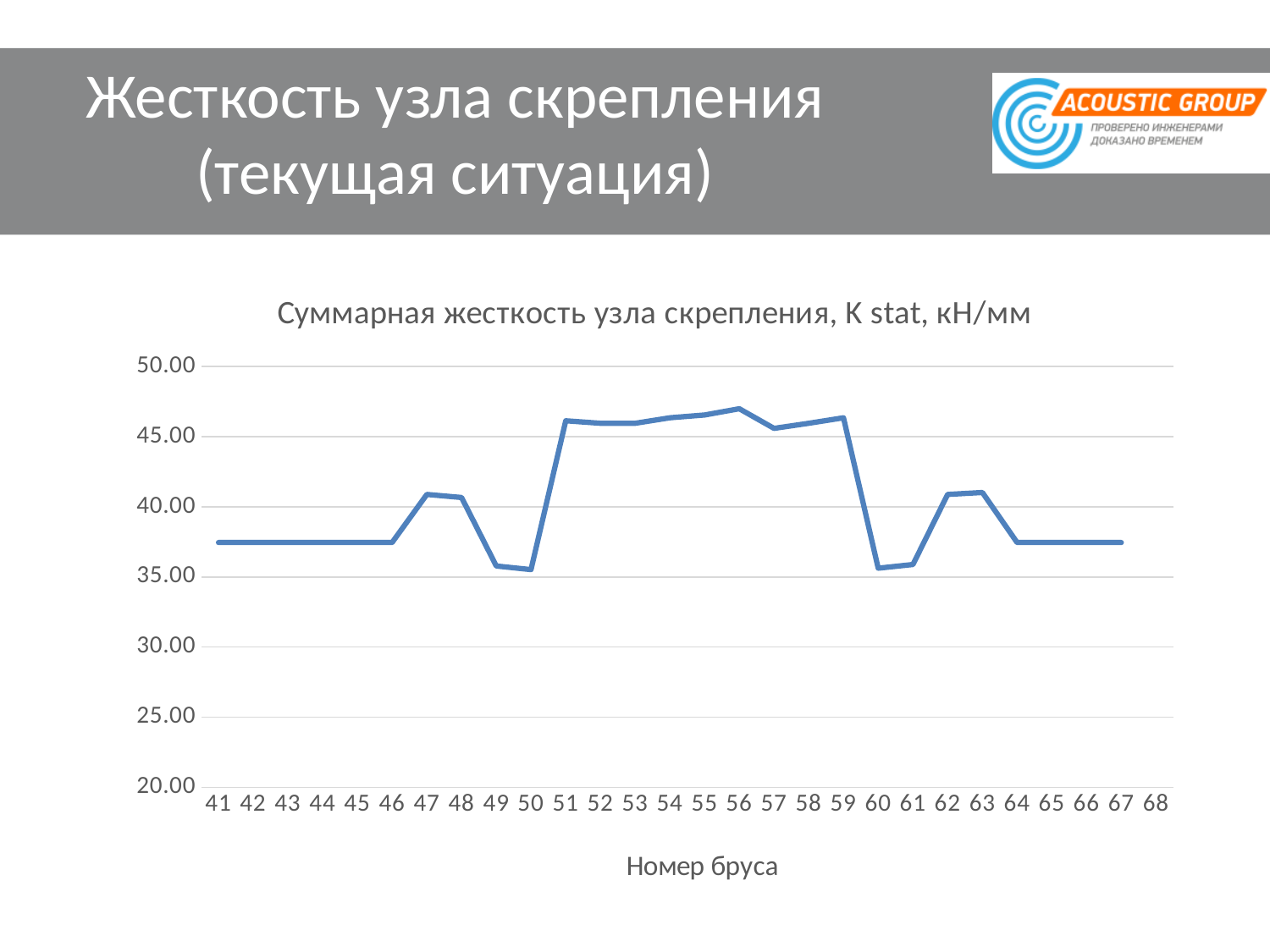
Is the value for beam number 51 greater or less than 45.00? greater Which has the larger value, beam number 62 or beam number 60? 62 Is the value for beam number 50 greater or less than 40.00? less Is the value for beam number 43 greater or less than 35.00? greater Which has the larger value, beam number 49 or beam number 45? 45 Which has the larger value, beam number 51 or beam number 47? 51 What is the title of the chart? Суммарная жесткость узла скрепления, K stat, кН/мм What kind of chart is shown on the slide? line chart Does the value rise or fall from beam number 59 to beam number 60? fall What is the x-axis title of the chart? Номер бруса